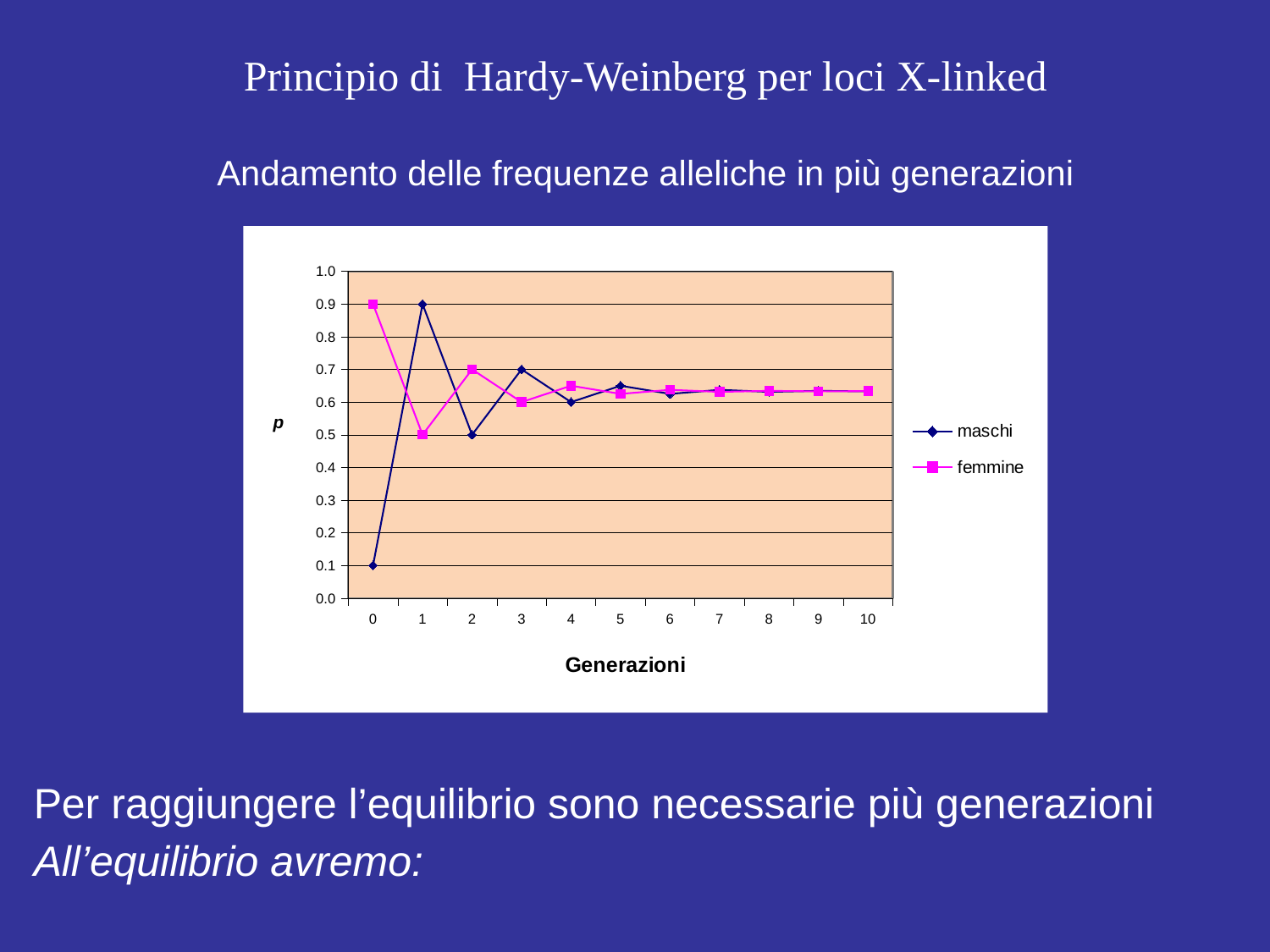
What is the difference between the femmine and maschi values of p at generation 0? 0.8 What is the value of p for femmine at generation 1? 0.5 What is the value of p for femmine at generation 0? 0.9 What are the names of the two series in the legend? maschi and femmine At which generation does the maschi series reach its lowest value of p? 0 How many generations are plotted along the x axis? 11 What kind of chart is shown on the slide? line chart At generation 0, which series has the higher value of p, maschi or femmine? femmine How many series does the chart legend list? 2 What is the label of the x axis? Generazioni What is the value of p for maschi at generation 0? 0.1 What is the value of p for maschi at generation 1? 0.9